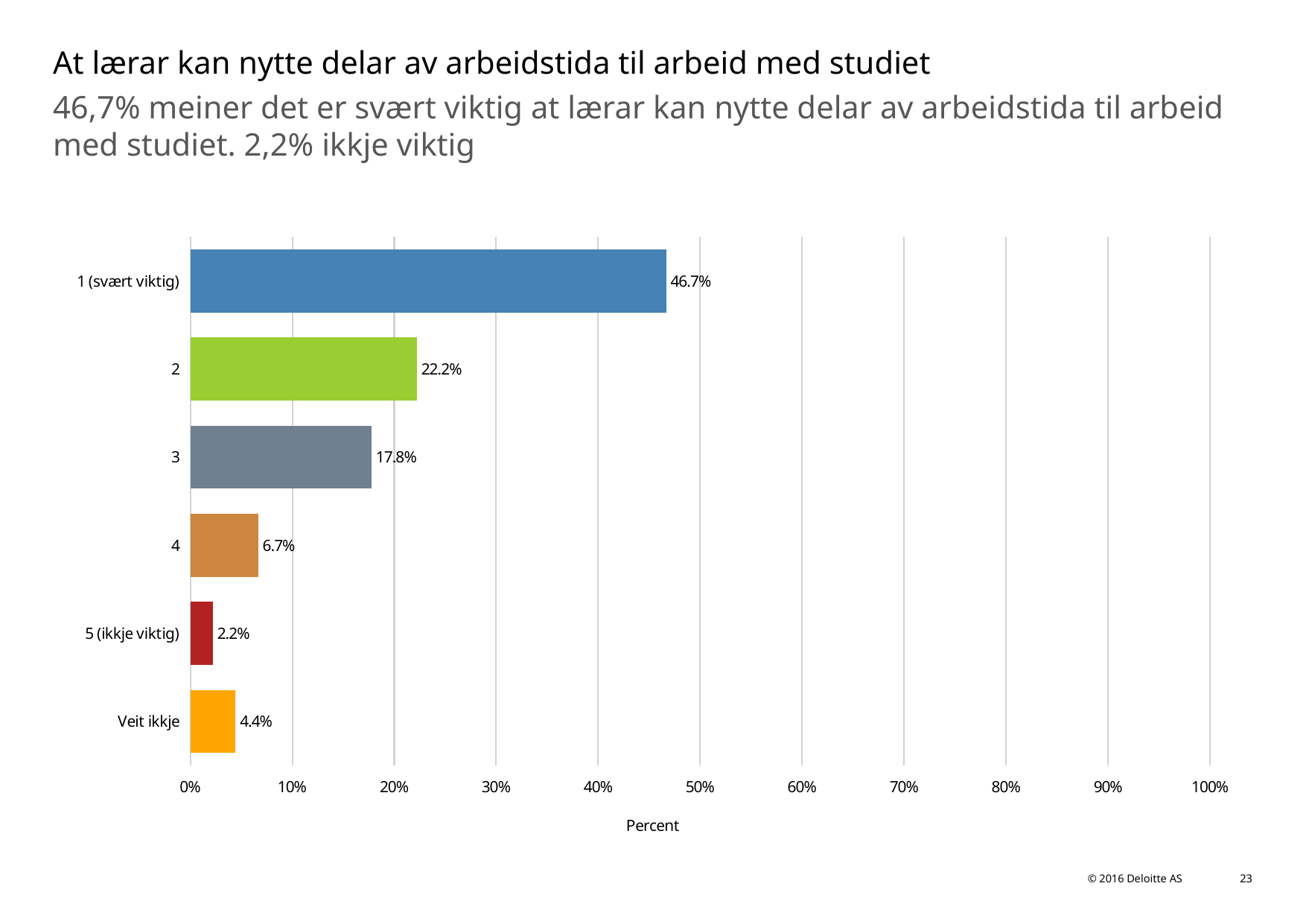
What kind of chart is shown on the slide? bar chart Which is larger, the value for "4" or the value for "Veit ikkje"? 4 Which category has the lowest value? 5 (ikkje viktig) Is the value for "1 (svært viktig)" greater or less than 40%? greater What is the value for category "3"? 17.8% What is the difference between the values for "1 (svært viktig)" and "2"? 24.5% What is the difference between the values for "2" and "3"? 4.4% What is the value for "Veit ikkje"? 4.4% How many categories are shown in the chart? 6 What is the value for "1 (svært viktig)"? 46.7% Which category has the highest value? 1 (svært viktig) What is the label of the horizontal axis? Percent